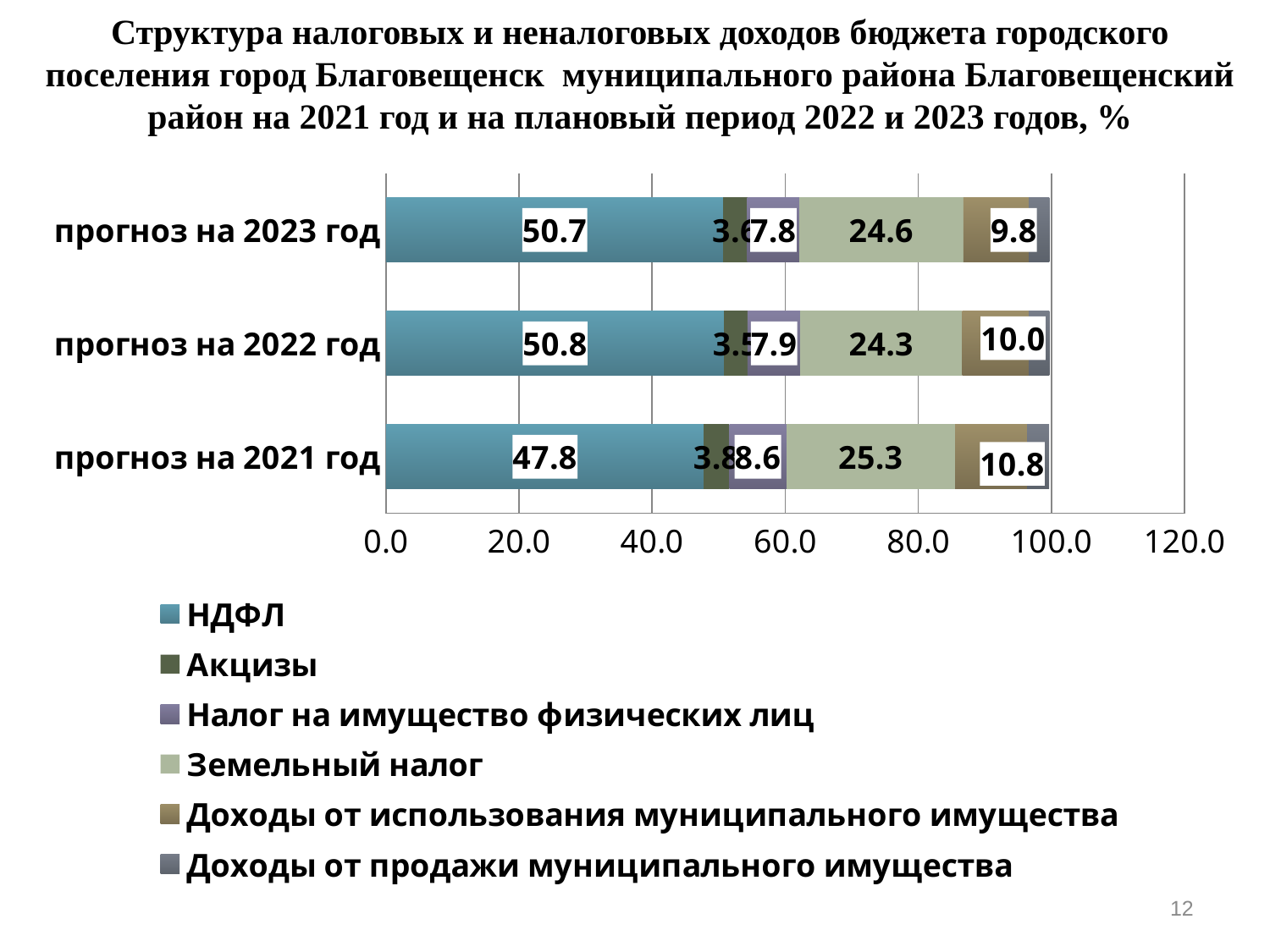
How many categories (years) are shown on the chart? 3 What is the value for НДФЛ in прогноз на 2021 год? 47.8 What is the difference between the Доходы от использования муниципального имущества values for прогноз на 2021 год and прогноз на 2022 год? 0.8 What is the difference between the Земельный налог values for прогноз на 2021 год and прогноз на 2023 год? 0.7 What is the value for НДФЛ in прогноз на 2022 год? 50.8 What is the value for Земельный налог in прогноз на 2023 год? 24.6 In which year is the НДФЛ value the lowest? прогноз на 2021 год How many series does the legend list? 6 What kind of chart is shown on the slide? stacked bar chart What is the value for Доходы от использования муниципального имущества in прогноз на 2022 год? 10.0 In which year is the Земельный налог value the highest? прогноз на 2021 год Which is larger, the НДФЛ value for прогноз на 2021 год or for прогноз на 2023 год? прогноз на 2023 год